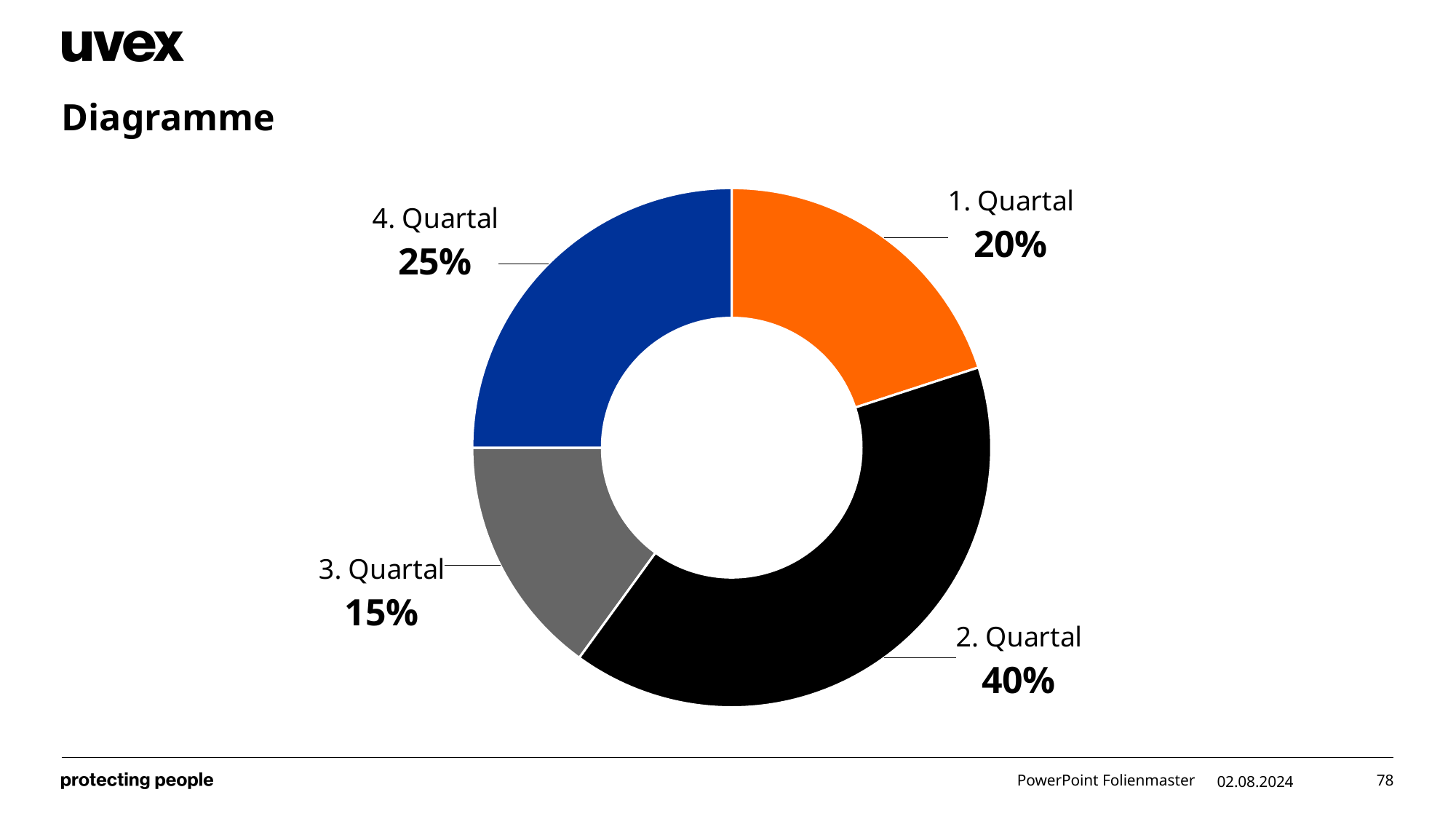
How many categories does the chart show? 4 What is the value for 3. Quartal? 15% What is the value for 2. Quartal? 40% Which category has the largest share? 2. Quartal Which category has the smallest share? 3. Quartal What is the title of the slide containing the chart? Diagramme What colour is the slice for 2. Quartal? Black What is the value for 4. Quartal? 25% What kind of chart is shown on the slide? Doughnut (pie) chart What is the difference between the values for 2. Quartal and 4. Quartal? 15% Which is larger, the value for 1. Quartal or the value for 3. Quartal? 1. Quartal What is the value for 1. Quartal? 20%